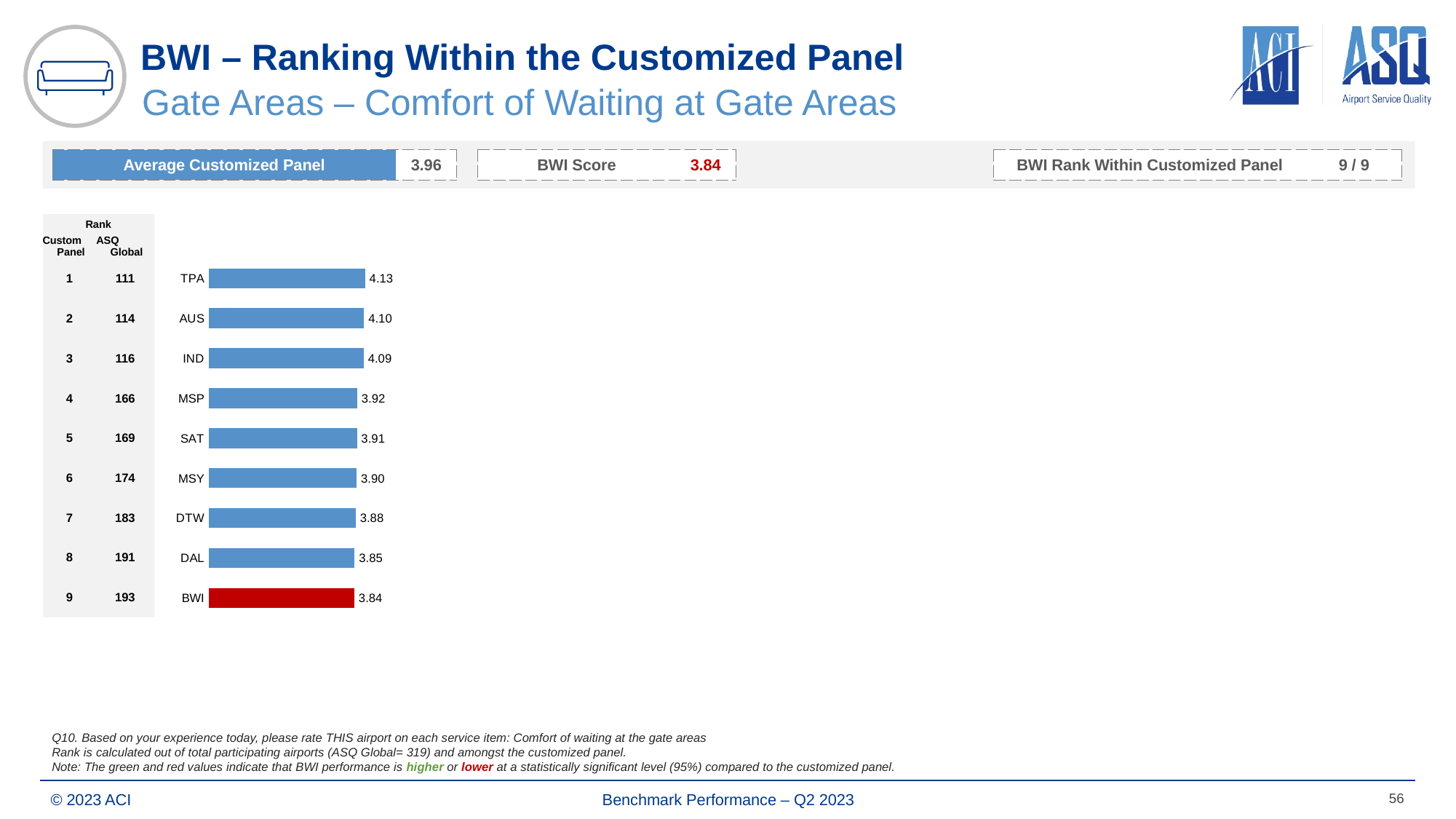
Which airport has the highest value? TPA What is the difference between the values for TPA and BWI? 0.29 What is the value for DAL? 3.85 What is the value for MSP? 3.92 What is the Average Customized Panel score shown on the slide? 3.96 Which bar is coloured red? BWI Which is larger, the value for IND or the value for DTW? IND Which airport has the lowest value? BWI What kind of chart is shown? Bar chart How many airports are shown in the chart? 9 What is the difference between the values for AUS and IND? 0.01 What is the value for TPA? 4.13